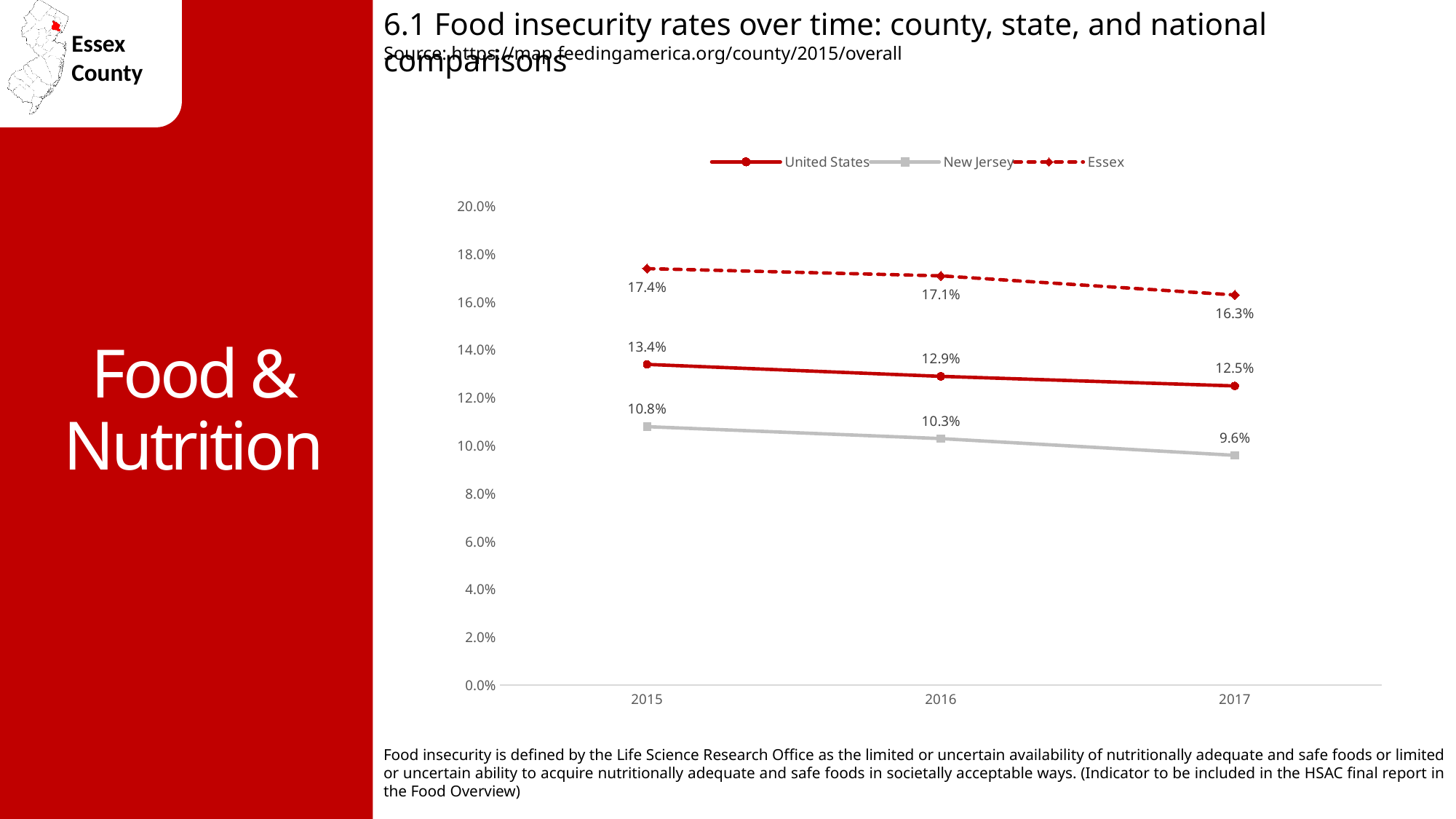
What was the food insecurity rate for Essex in 2015? 17.4% Which series had the highest food insecurity rate in 2017? Essex Is the Essex food insecurity rate in 2017 greater or less than 16.0%? greater What was the food insecurity rate for New Jersey in 2017? 9.6% How many series does the legend list? 3 Which series had the lowest food insecurity rate in 2015? New Jersey What was the food insecurity rate for the United States in 2016? 12.9% Does the Essex food insecurity rate rise or fall from 2015 to 2017? Fall How many years are shown on the x axis? 3 Which was larger in 2017, the United States rate or the New Jersey rate? United States What is the difference between the Essex and New Jersey food insecurity rates in 2016? 6.8% What kind of chart is shown on the slide? Line chart